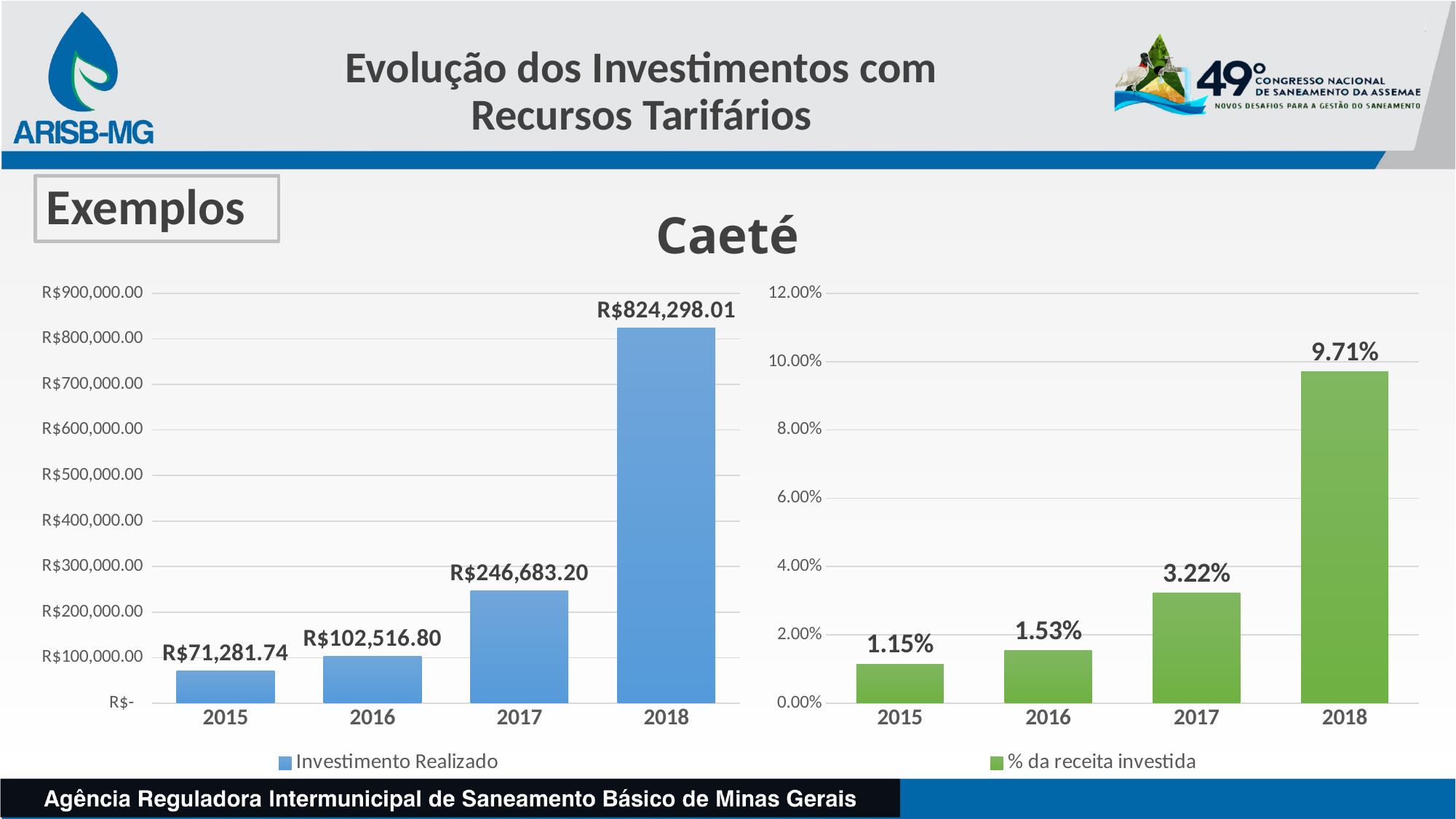
How many years are shown on the x axis of the left chart (Investimento Realizado)? 4 In the left chart (Investimento Realizado), which year has the lowest value? 2015 In the right chart (% da receita investida), what is the difference between the 2018 and 2017 values? 6.49% In the left chart (Investimento Realizado), what is the value for 2018? R$824,298.01 In the left chart (Investimento Realizado), is the value for 2017 greater or less than R$300,000.00? less In the right chart (% da receita investida), which year has the highest value? 2018 What type of chart is the right chart (% da receita investida)? bar chart In the right chart (% da receita investida), what is the value for 2016? 1.53% In the right chart (% da receita investida), do the values rise or fall from 2015 to 2018? rise In the left chart (Investimento Realizado), what is the difference between the 2018 and 2017 values? R$577,614.81 In the left chart (Investimento Realizado), what is the value for 2015? R$71,281.74 In the right chart (% da receita investida), what is the value for 2017? 3.22%